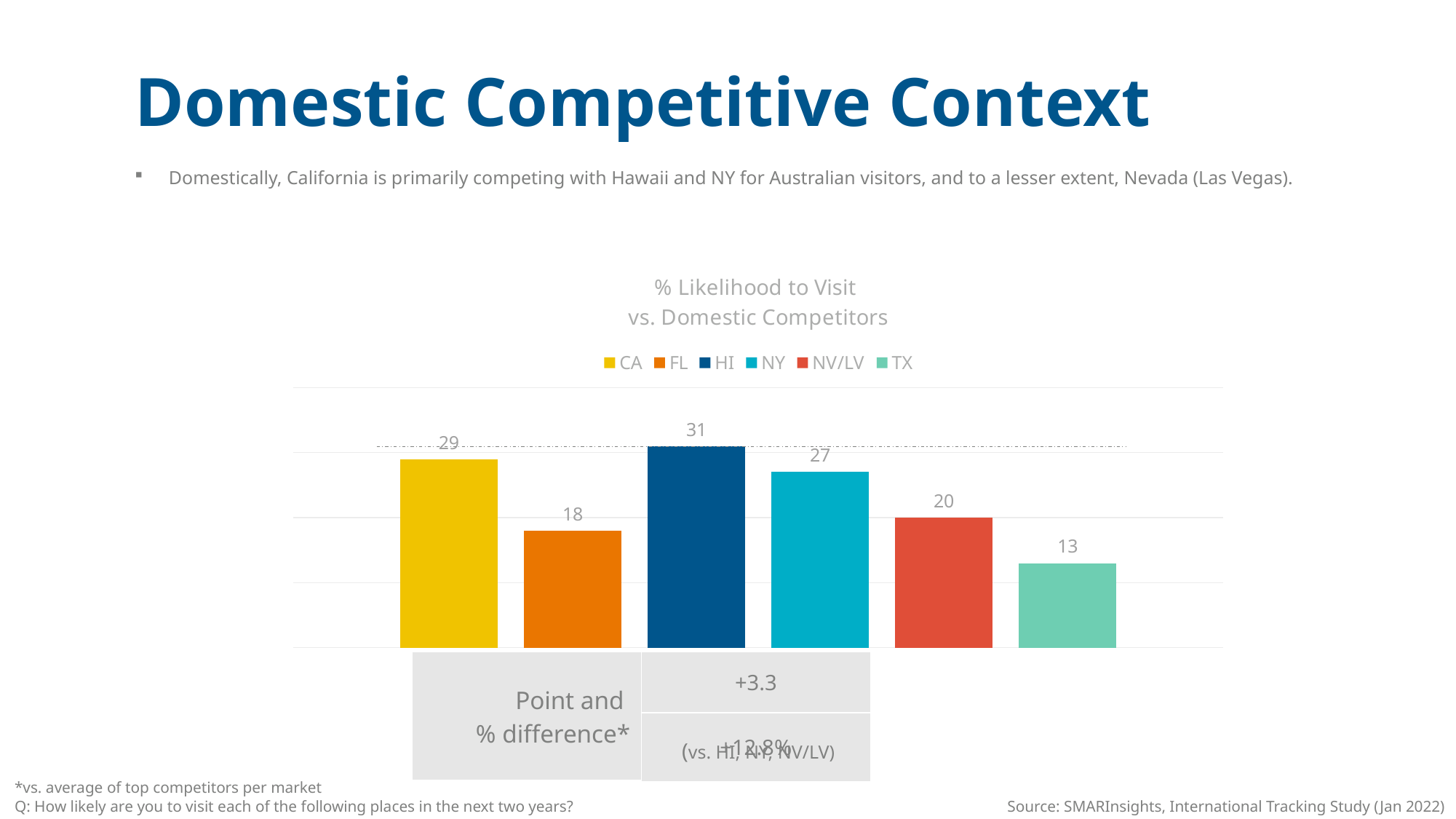
What is the difference between the values for NY and FL? 9 What is the difference between the values for HI and CA? 2 How many entries does the legend list? 6 Which state has the lowest % likelihood to visit? TX What is the % likelihood to visit value for HI? 31 What is the % likelihood to visit value for NV/LV? 20 Which is larger, the value for FL or the value for NV/LV? NV/LV Which state has the highest % likelihood to visit? HI How many states are shown in the chart? 6 What is the % likelihood to visit value for CA? 29 What type of chart is shown on the slide? Bar chart What is the % likelihood to visit value for TX? 13